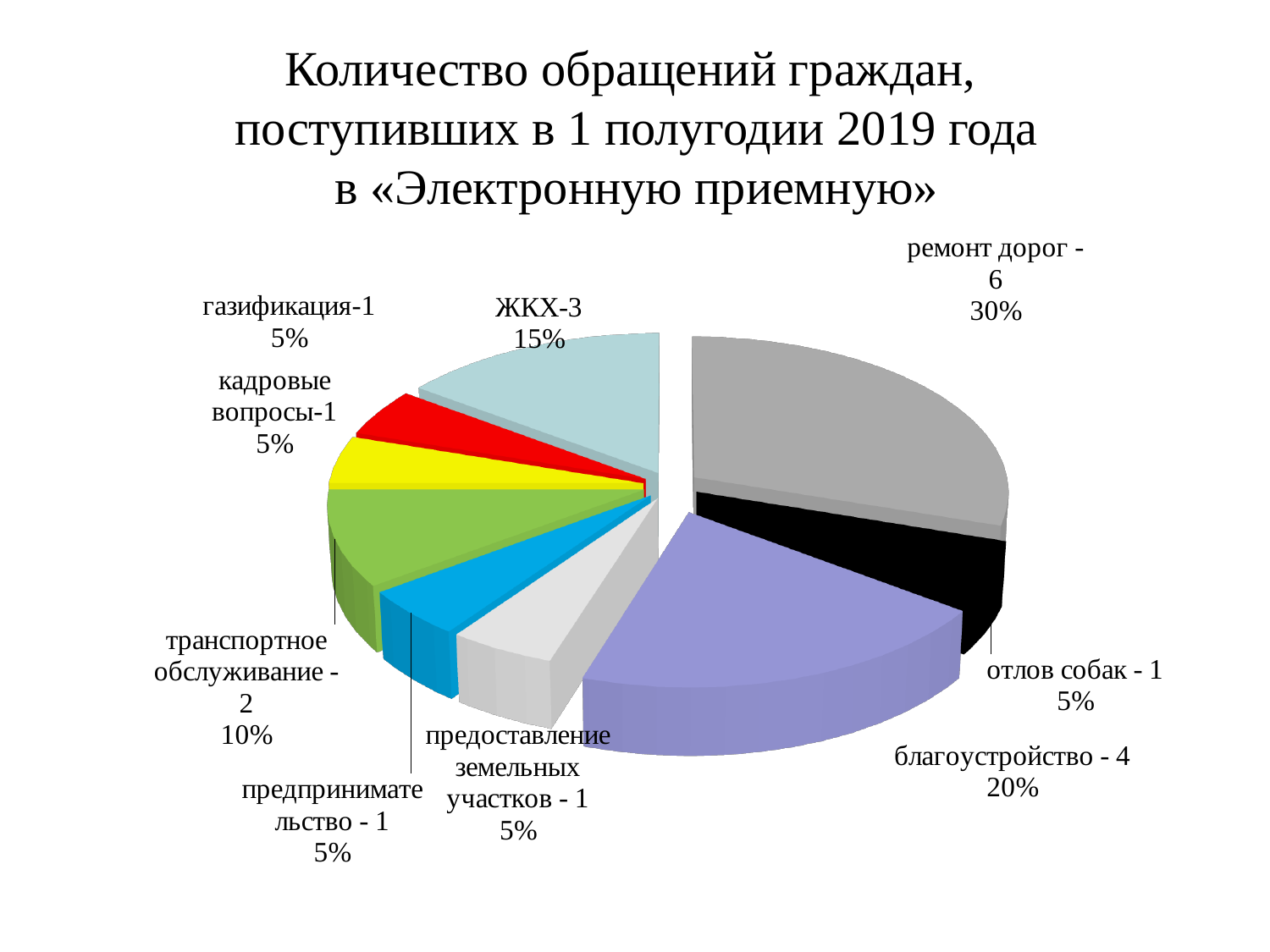
What is the title of the chart on the slide? Количество обращений граждан, поступивших в 1 полугодии 2019 года в «Электронную приемную» How many appeals are shown for "транспортное обслуживание"? 2 What kind of chart is shown on the slide? pie chart Which has the larger share: "ЖКХ" or "транспортное обслуживание"? ЖКХ What is the difference in percentage points between the shares of "ремонт дорог" and "благоустройство"? 10% What share of the pie does "благоустройство" account for? 20% How many appeals are shown for "ремонт дорог"? 6 What share of the pie does "ЖКХ" account for? 15% Which category has the largest slice of the pie? ремонт дорог What share of the pie does "ремонт дорог" account for? 30% How many categories does the pie chart show? 9 What is the total number of appeals across all categories in the pie chart? 20